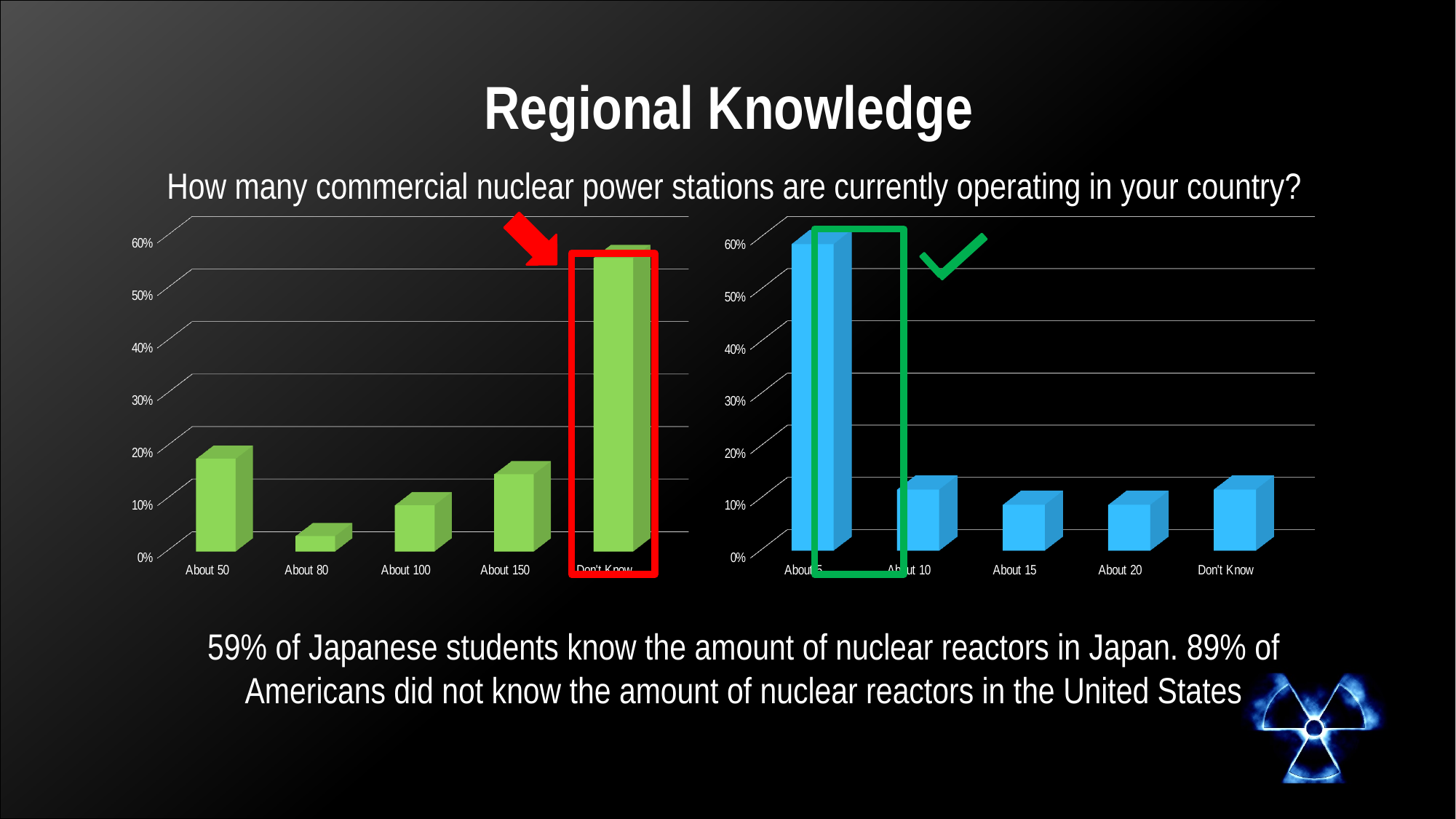
In the right chart (blue bars), which category has the highest value? About 5 In the left chart (green bars), is the value for Don't Know greater or less than 50%? greater In the left chart (green bars), which category has the lowest value? About 80 In the left chart (green bars), is the value for About 50 greater or less than 20%? less In the left chart (green bars), which is larger, the value for About 50 or the value for About 100? About 50 In the right chart (blue bars), is the value for About 5 greater or less than 50%? greater What kind of chart is the right chart (blue bars)? bar chart In the left chart (green bars), which category has the highest value? Don't Know How many categories are shown on the x axis of the left chart (green bars)? 5 What is the highest percentage tick shown on the y axis of the left chart (green bars)? 60% In the right chart (blue bars), which is larger, the value for About 5 or the value for Don't Know? About 5